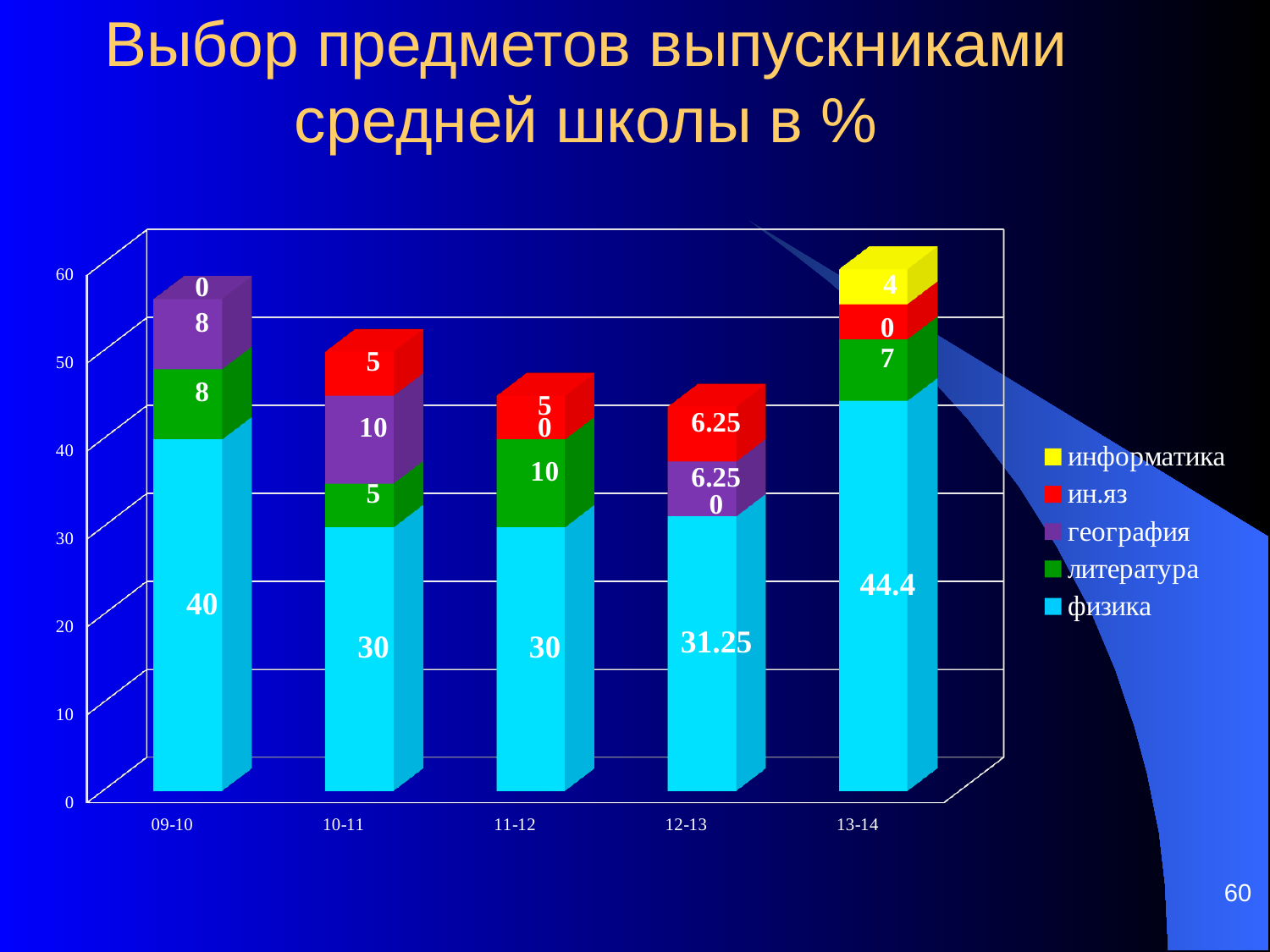
In which year is the value for физика the highest? 13-14 How many series does the legend list? 5 What is the value for физика in 13-14? 44.4 What is the value for физика in 09-10? 40 What is the value for география in 10-11? 10 How many years are shown on the x axis? 5 What is the difference between the физика values for 09-10 and 10-11? 10 What is the value for ин.яз in 12-13? 6.25 What is the value for информатика in 13-14? 4 Which year has the larger литература value, 09-10 or 10-11? 09-10 In which year is the value for литература the highest? 11-12 What is the total of the stacked bar for 10-11? 50